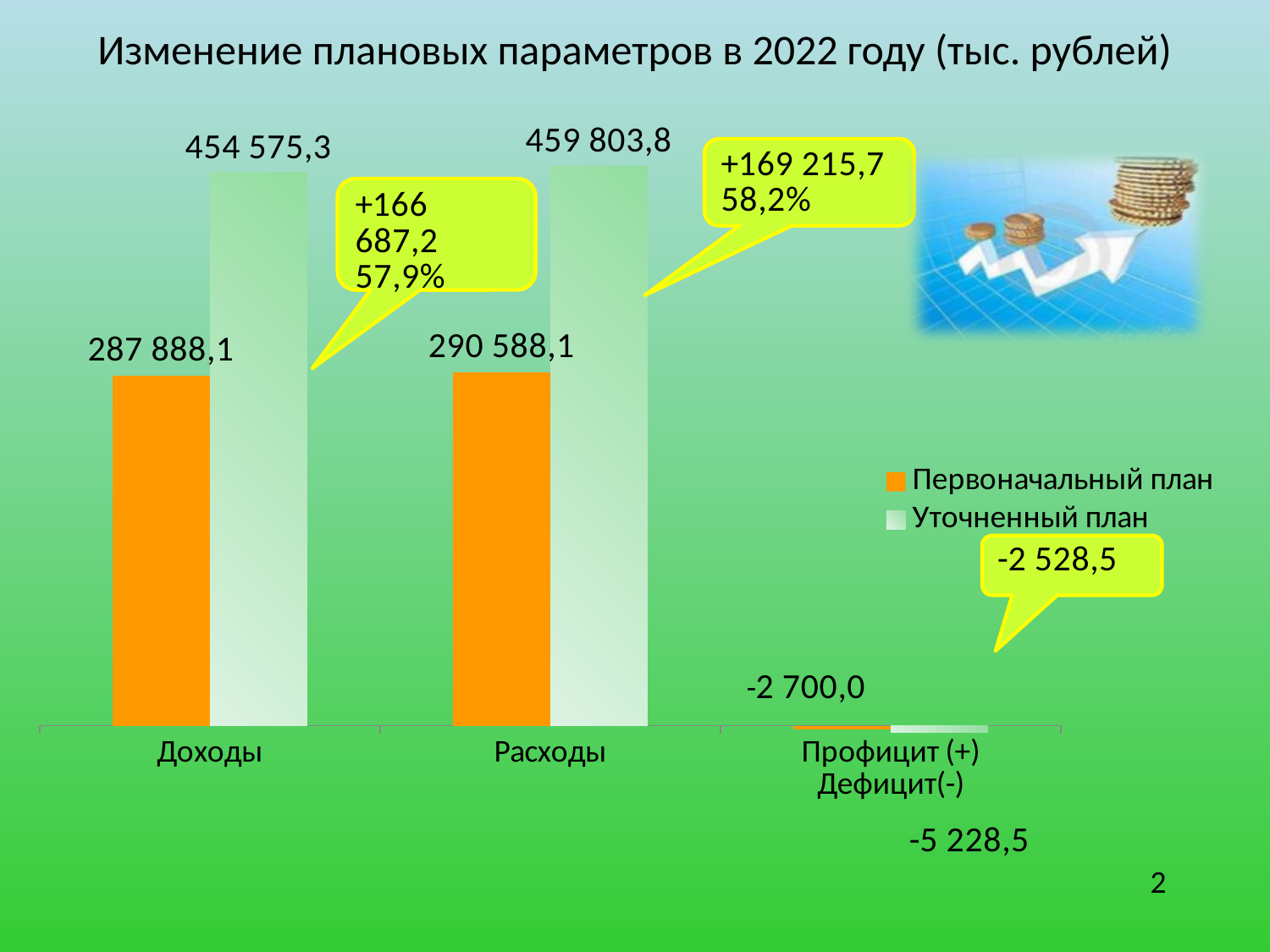
How many categories are shown on the x axis? 3 What is the value of Уточненный план for Доходы? 454 575,3 What type of chart is shown on the slide? Bar chart Which is larger: the Первоначальный план value for Расходы or for Доходы? Расходы How many series does the legend list? 2 What is the difference between the Уточненный план and Первоначальный план values for Доходы? 166 687,2 What is the value of Уточненный план for Расходы? 459 803,8 What is the value of Первоначальный план for Доходы? 287 888,1 Which category has the lowest Первоначальный план value? Профицит (+) Дефицит(-) What is the value of Уточненный план for Профицит (+) Дефицит(-)? -5 228,5 What is the value of Первоначальный план for Профицит (+) Дефицит(-)? -2 700,0 Which category has the highest Уточненный план value? Расходы